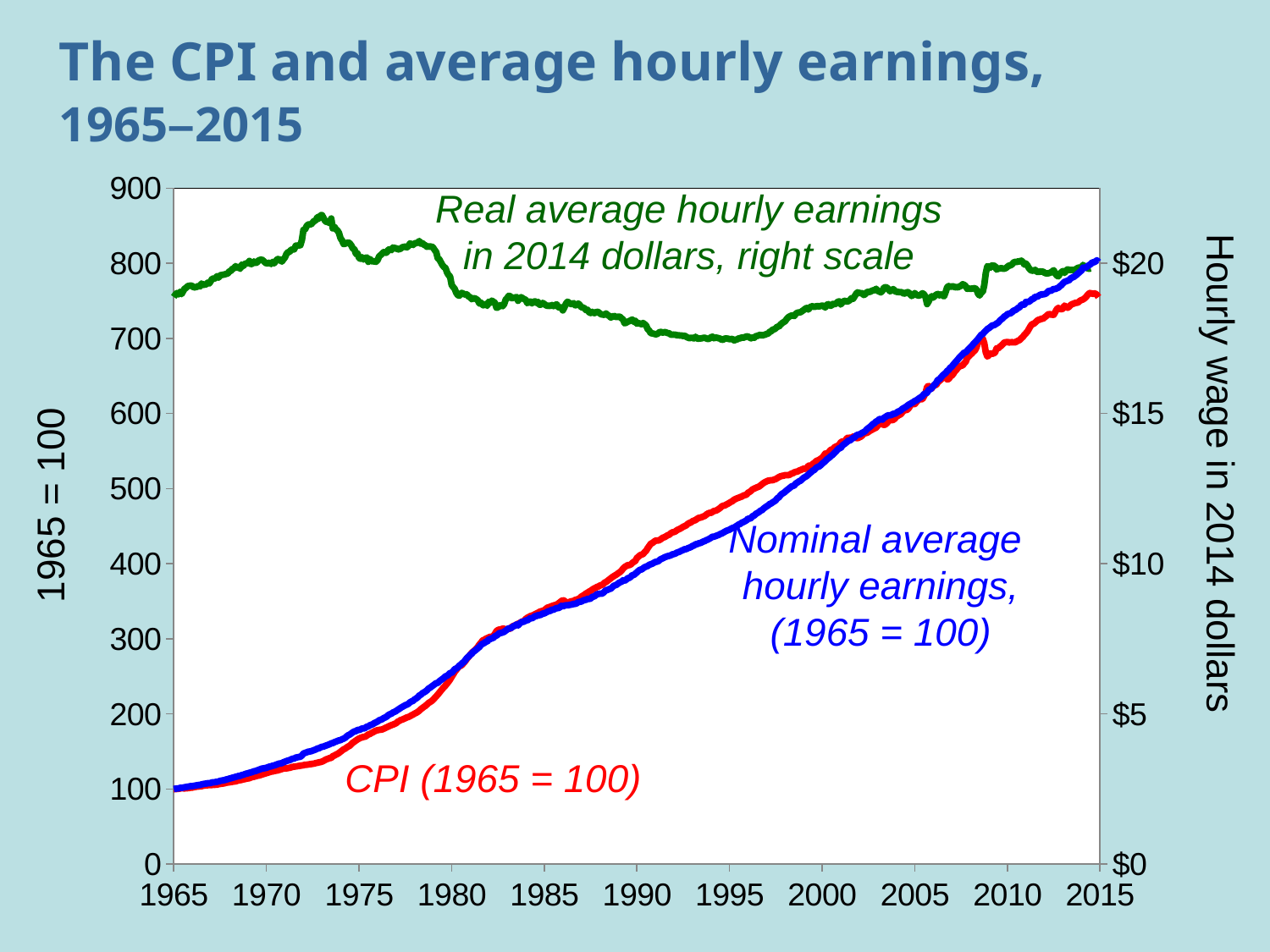
What is the value of the Nominal average hourly earnings (1965 = 100) series in 1965? 100 Is the value of the CPI (1965 = 100) series in 2015 greater or less than 700? greater Is the value of the Nominal average hourly earnings series in 2015 greater or less than 700? greater In 2015, which is larger: the CPI (1965 = 100) or the Nominal average hourly earnings (1965 = 100)? Nominal average hourly earnings (1965 = 100) What kind of chart is shown on the slide? line chart What is the value of the CPI (1965 = 100) series in 1965? 100 Is the value of the Real average hourly earnings series in 1995 greater or less than $20 on the right scale? less Does the CPI (1965 = 100) series rise or fall from 1965 to 2015? rise In 1995, which is larger: the CPI (1965 = 100) or the Nominal average hourly earnings (1965 = 100)? CPI (1965 = 100) How many data series are plotted on the chart? 3 What is the title of the right-hand vertical axis? Hourly wage in 2014 dollars